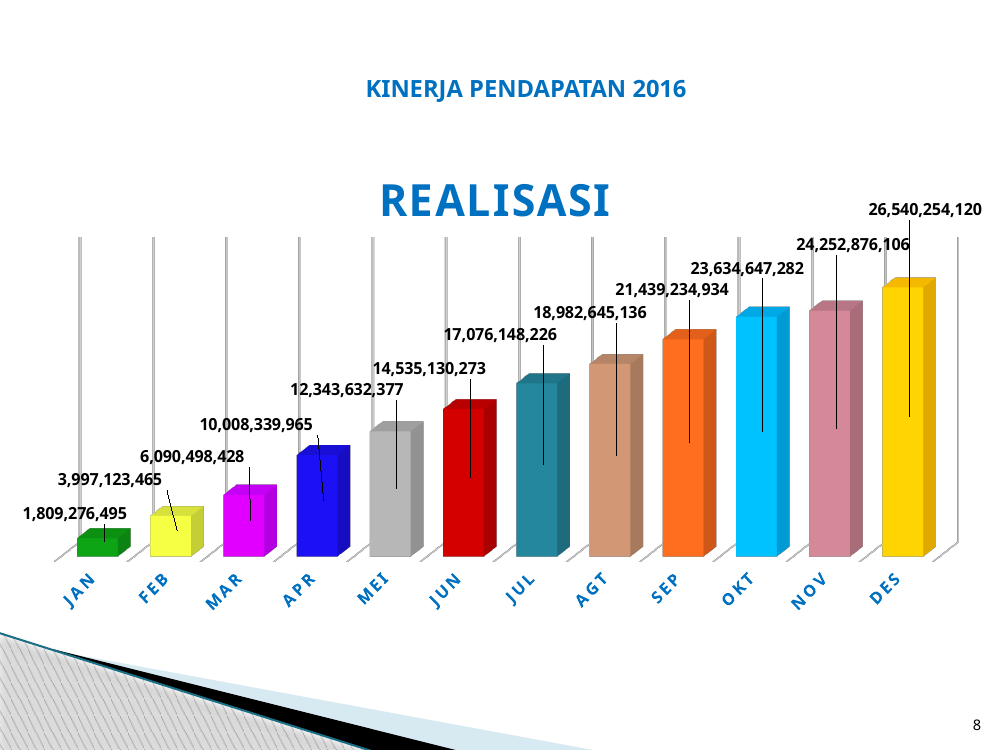
Which month has the lowest value? JAN What is the value for JAN? 1,809,276,495 Which month has the highest value? DES What kind of chart is shown on the slide? Bar chart What is the difference between the values for DES and NOV? 2,287,378,014 Do the values rise or fall from JAN to DES? Rise What is the difference between the values for FEB and JAN? 2,187,846,970 What is the value for MEI? 12,343,632,377 What is the value for DES? 26,540,254,120 What is the value for JUL? 17,076,148,226 How many months are shown on the chart? 12 Which is larger, the value for APR or the value for SEP? SEP